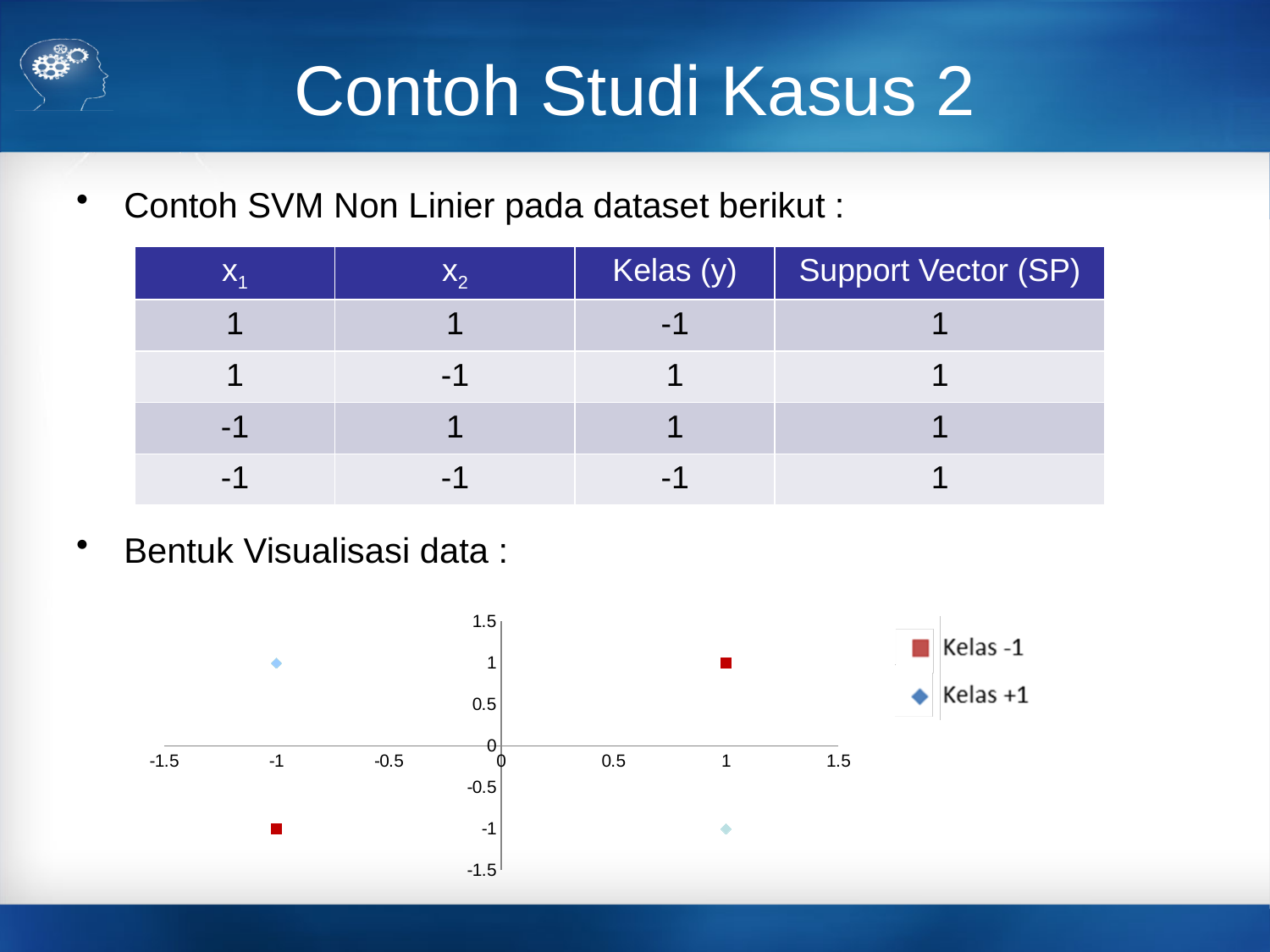
Which legend entry is represented by red squares on the chart? Kelas -1 What is the x-coordinate of the Kelas +1 point that lies in the lower-right quadrant of the chart? 1 How many points belong to the Kelas -1 series on the chart? 2 What is the highest value shown on the chart's vertical axis? 1.5 What kind of chart is shown under "Bentuk Visualisasi data"? scatter chart How many points belong to the Kelas +1 series on the chart? 2 How many data points are plotted on the scatter chart? 4 How many series does the chart legend list? 2 What is the y-coordinate of the Kelas +1 point that lies in the upper-left quadrant of the chart? 1 What is the x-coordinate of the Kelas -1 point that lies in the upper-right quadrant of the chart? 1 Is the y-coordinate of the Kelas +1 point in the lower-right quadrant greater or less than 0? less What is the y-coordinate of the Kelas -1 point that lies in the lower-left quadrant of the chart? -1